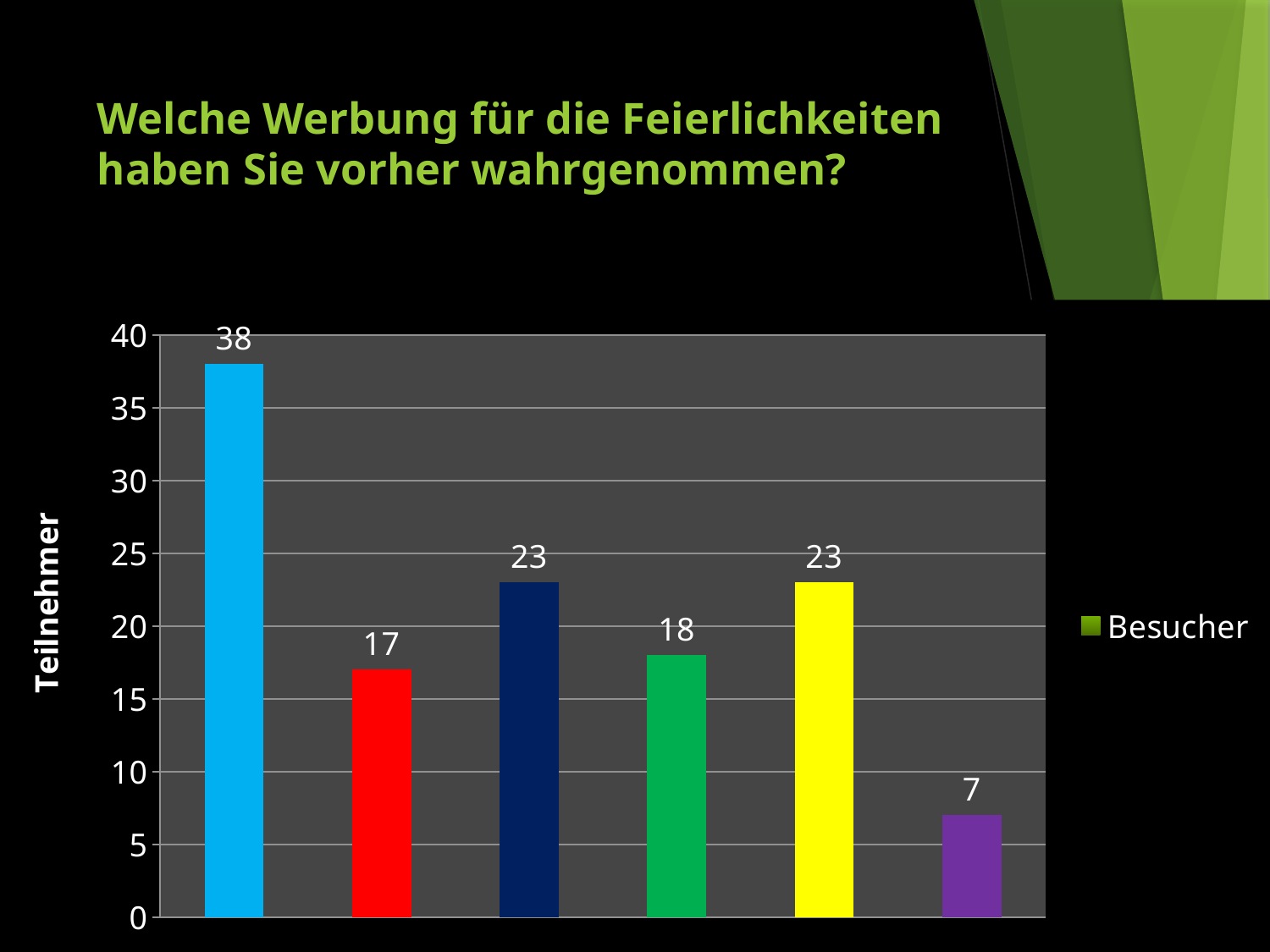
What is the name of the series shown in the legend? Besucher Which bar has the lowest value? the purple bar (last on the right), 7 What is the value of the light blue bar (first from the left)? 38 What is the difference between the light blue bar (38) and the purple bar (7)? 31 What is the value of the green bar (fourth from the left)? 18 What is the value of the purple bar (last on the right)? 7 What type of chart is shown on the slide? bar chart What is the label on the vertical axis? Teilnehmer How many bars are plotted in the chart? 6 What is the value of the red bar (second from the left)? 17 Which bar has the highest value? the light blue bar (first from the left), 38 How many series does the legend list? 1